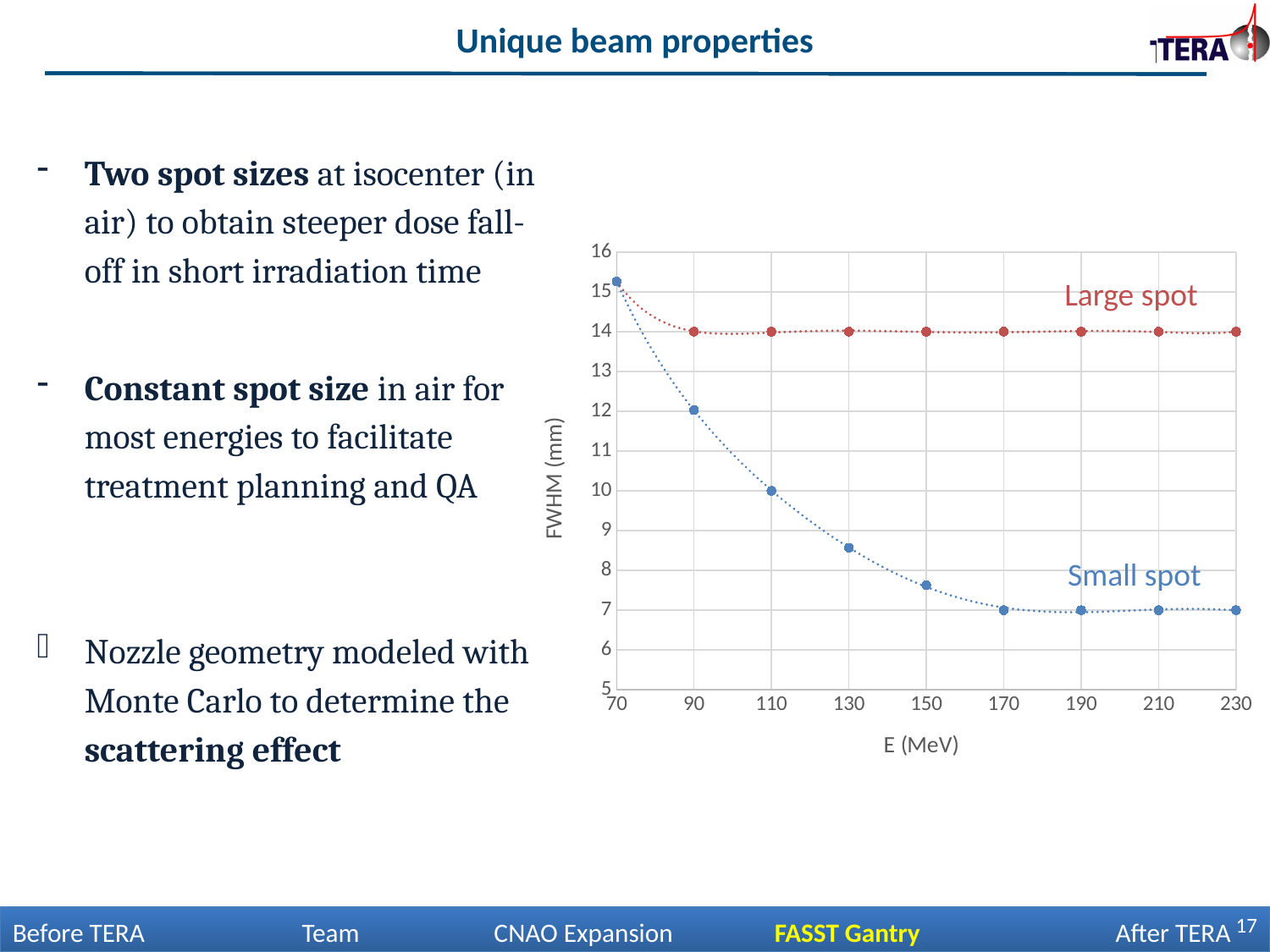
What is the label of the y axis? FWHM (mm) What are the names of the two series plotted on the chart? Large spot and Small spot At which energy does the Small spot series reach its highest FWHM? 70 How many series are plotted on the chart? 2 What kind of chart is shown on the slide? line chart What is the FWHM of the Small spot at 110 MeV? 10 At 130 MeV, which series has the larger FWHM, Large spot or Small spot? Large spot Is the FWHM of the Large spot at 70 MeV greater or less than 15? greater Does the FWHM of the Small spot rise or fall as energy increases from 70 to 170 MeV? fall How many data points does the Small spot series have? 9 Is the FWHM of the Small spot at 130 MeV greater or less than 9? less What is the FWHM of the Large spot at 150 MeV? 14